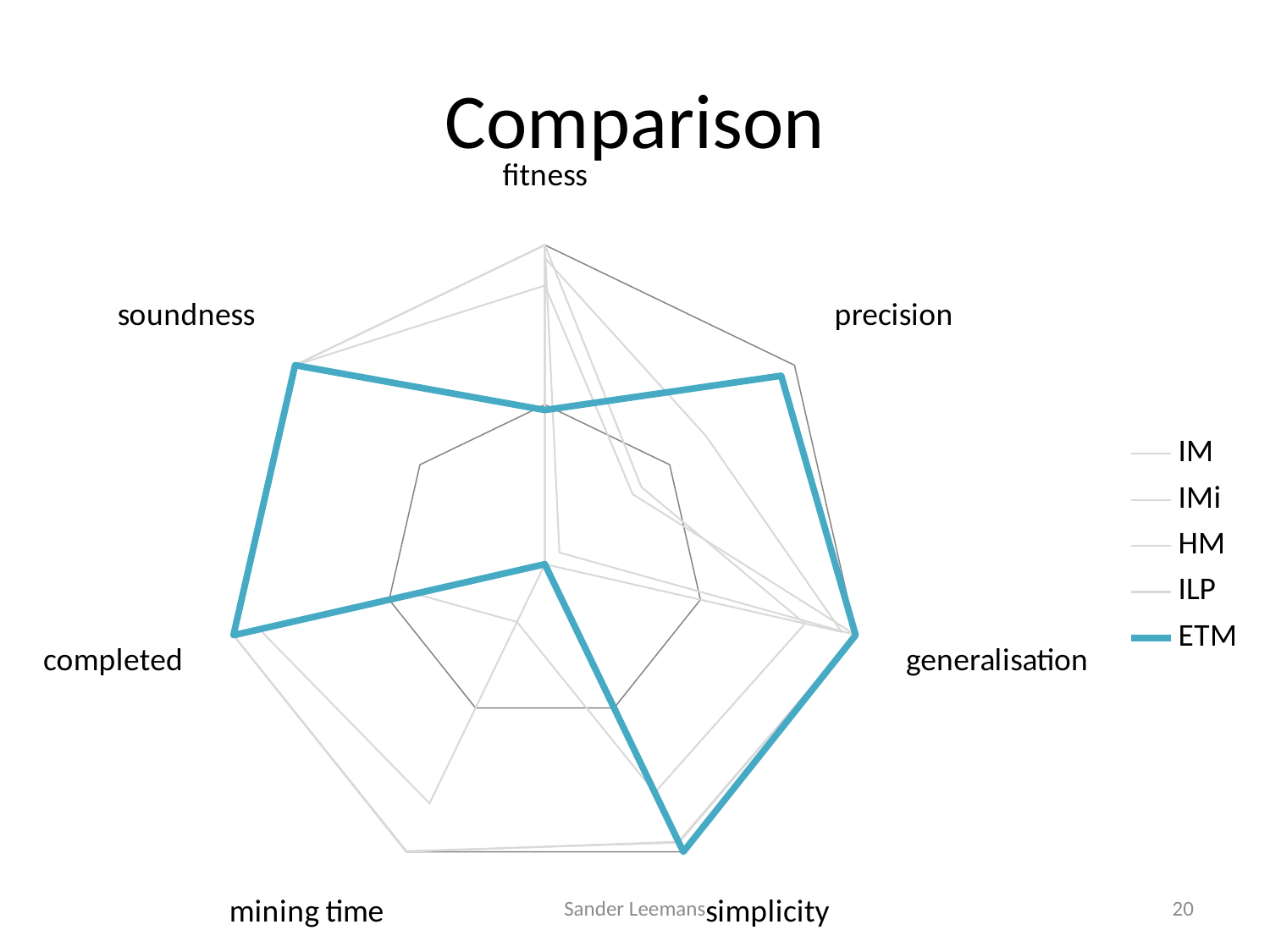
On which axis does the ETM series have its lowest value? mining time What is the title of the chart? Comparison What kind of chart is shown on the slide? radar chart For the ETM series, which is larger: the value for simplicity or the value for mining time? simplicity How many axes (categories) does the radar chart have? 7 For the ETM series, which is larger: the value for soundness or the value for fitness? soundness Which series is drawn with the thick blue line? ETM For the ETM series, which is larger: the value for precision or the value for fitness? precision How many series does the legend list? 5